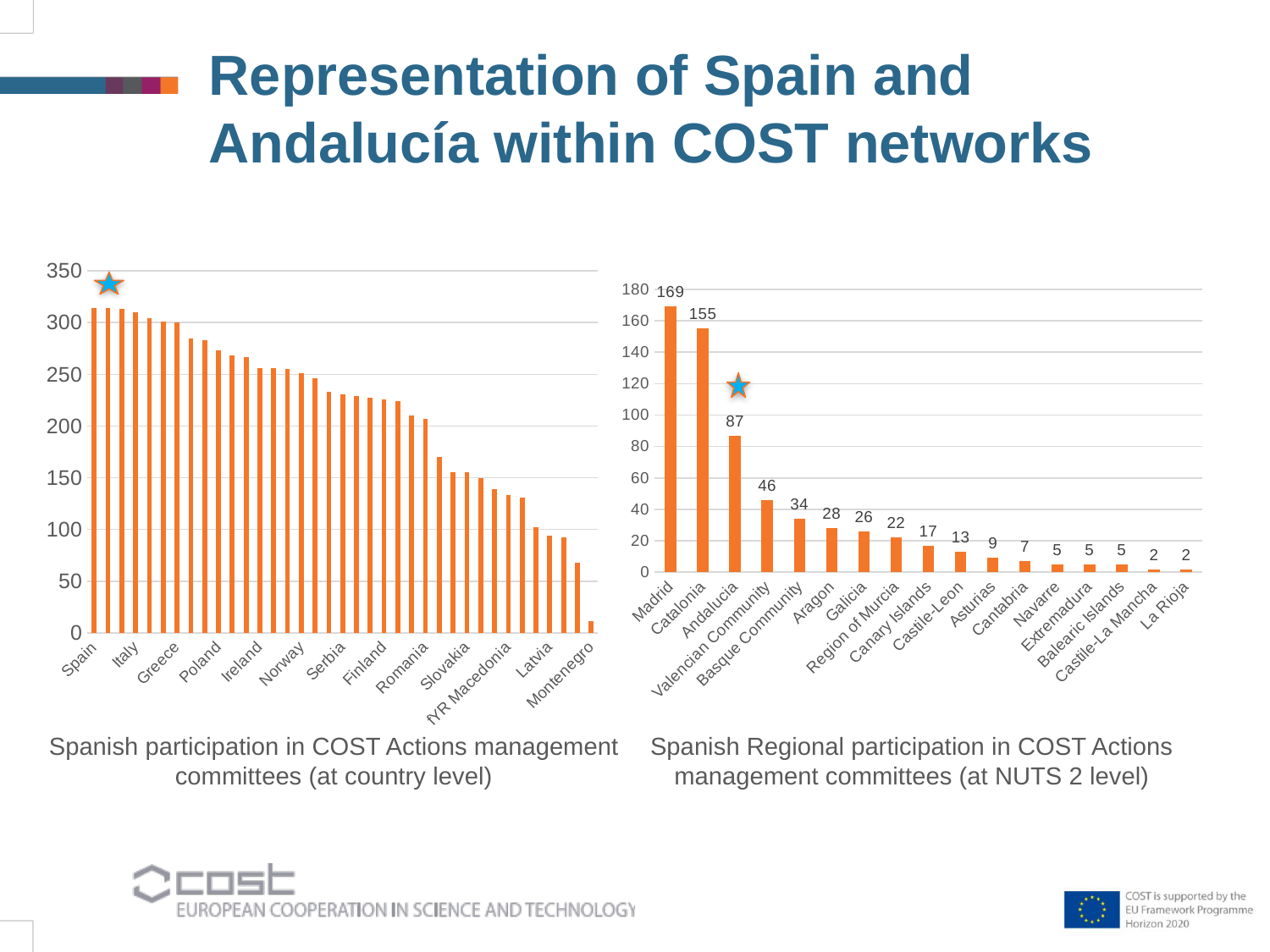
In the right chart (Spanish Regional participation), how many regions are shown? 17 In the right chart (Spanish Regional participation), what is the difference between Andalucia and Valencian Community? 41 What type of chart is the left chart (Spanish participation at country level)? Bar chart In the right chart (Spanish Regional participation), what is the value for Galicia? 26 In the right chart (Spanish Regional participation), what is the value for Andalucia? 87 In the left chart (Spanish participation at country level), do the values rise or fall from left to right? fall In the right chart (Spanish Regional participation), which region has the highest value? Madrid In the right chart (Spanish Regional participation), which is larger, Aragon or Region of Murcia? Aragon In the left chart (Spanish participation at country level), is the value for Spain greater or less than 300? greater In the left chart (Spanish participation at country level), is the value for Montenegro greater or less than 50? less In the right chart (Spanish Regional participation), what is the difference between Madrid and Catalonia? 14 In the right chart (Spanish Regional participation), what is the value for Madrid? 169